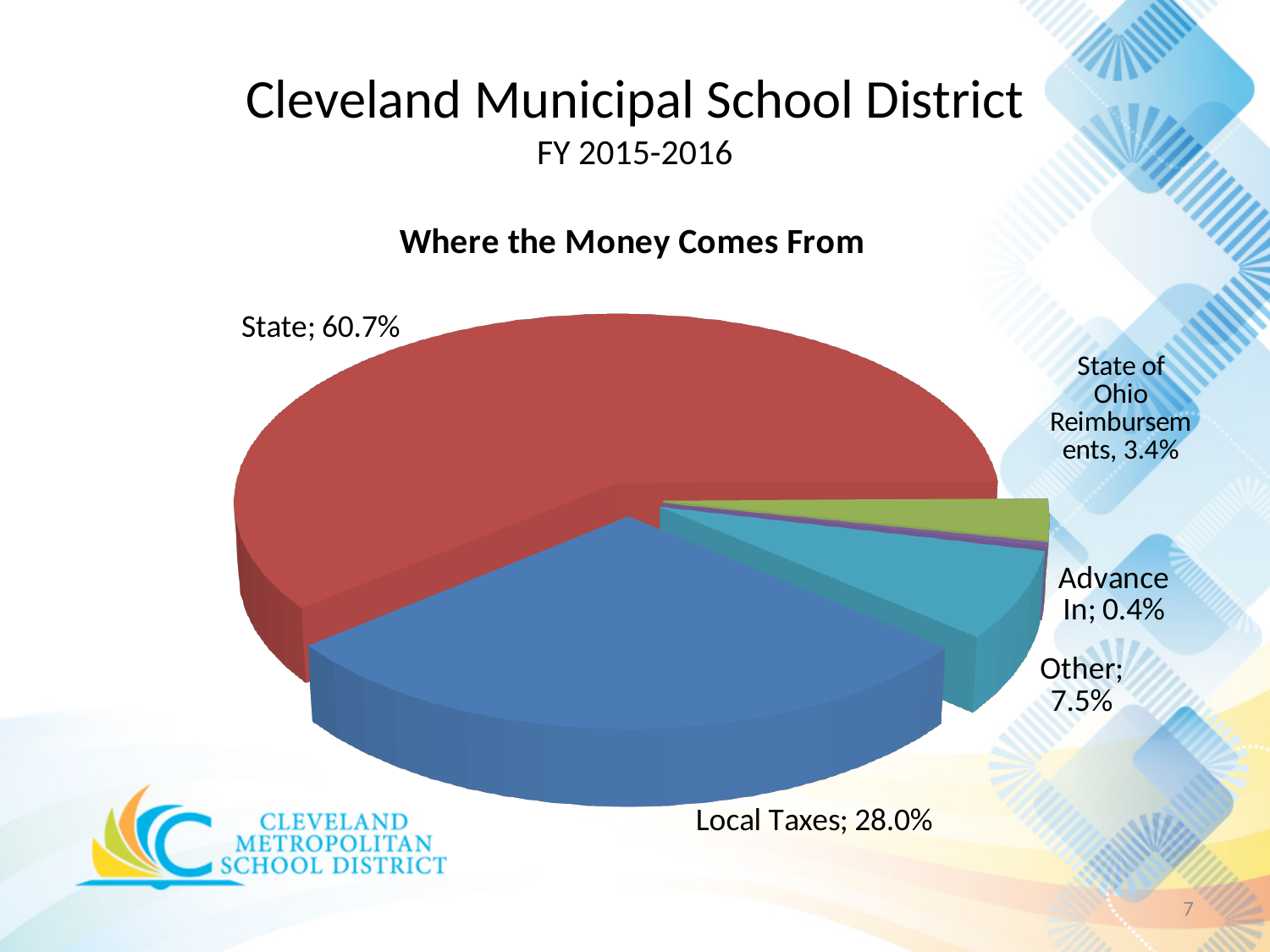
Which source provides the smallest share of the money? Advance In Which source provides the largest share of the money? State What share of the money comes from State of Ohio Reimbursements? 3.4% Which is larger, the share from Other or the share from State of Ohio Reimbursements? Other How many sources of money are shown in the chart? 5 What share of the money comes from Local Taxes? 28.0% What share of the money comes from Advance In? 0.4% What is the difference in percentage points between the State share and the Local Taxes share? 32.7 What share of the money comes from State? 60.7% What share of the money comes from Other? 7.5% What is the title of the chart? Where the Money Comes From What kind of chart is shown on the slide? Pie chart